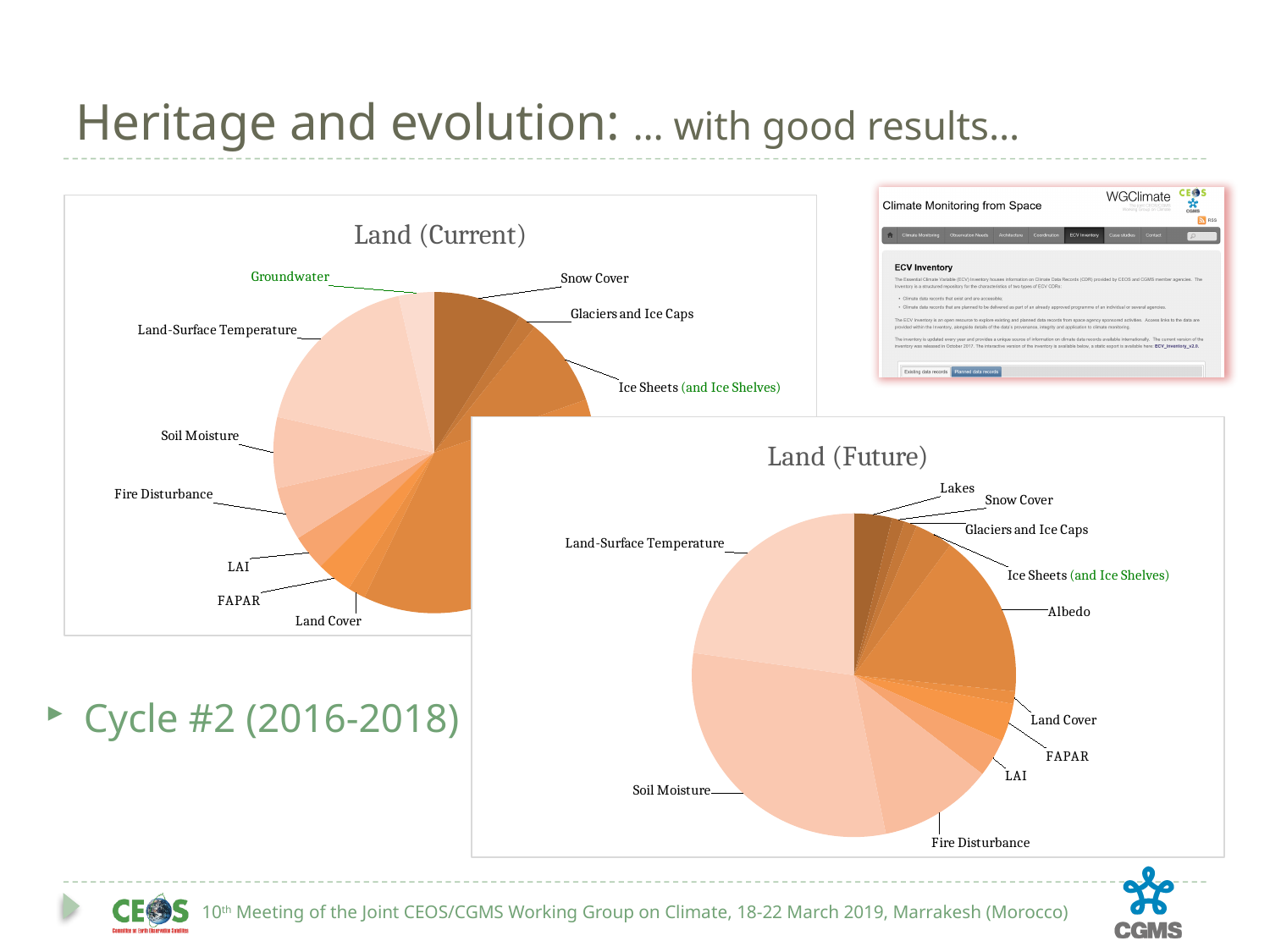
What kind of chart is the "Land (Current)" chart? pie chart In the "Land (Future)" chart, which category has the largest slice? Soil Moisture In the "Land (Current)" chart, which slice is larger: Soil Moisture or Fire Disturbance? Soil Moisture In the "Land (Current)" chart, which slice is larger: Land-Surface Temperature or Groundwater? Land-Surface Temperature In the "Land (Future)" chart, which slice is larger: Albedo or Land Cover? Albedo How many pie charts are shown on the slide? 2 What kind of chart is the "Land (Future)" chart? pie chart How many categories are shown in the "Land (Future)" pie chart? 11